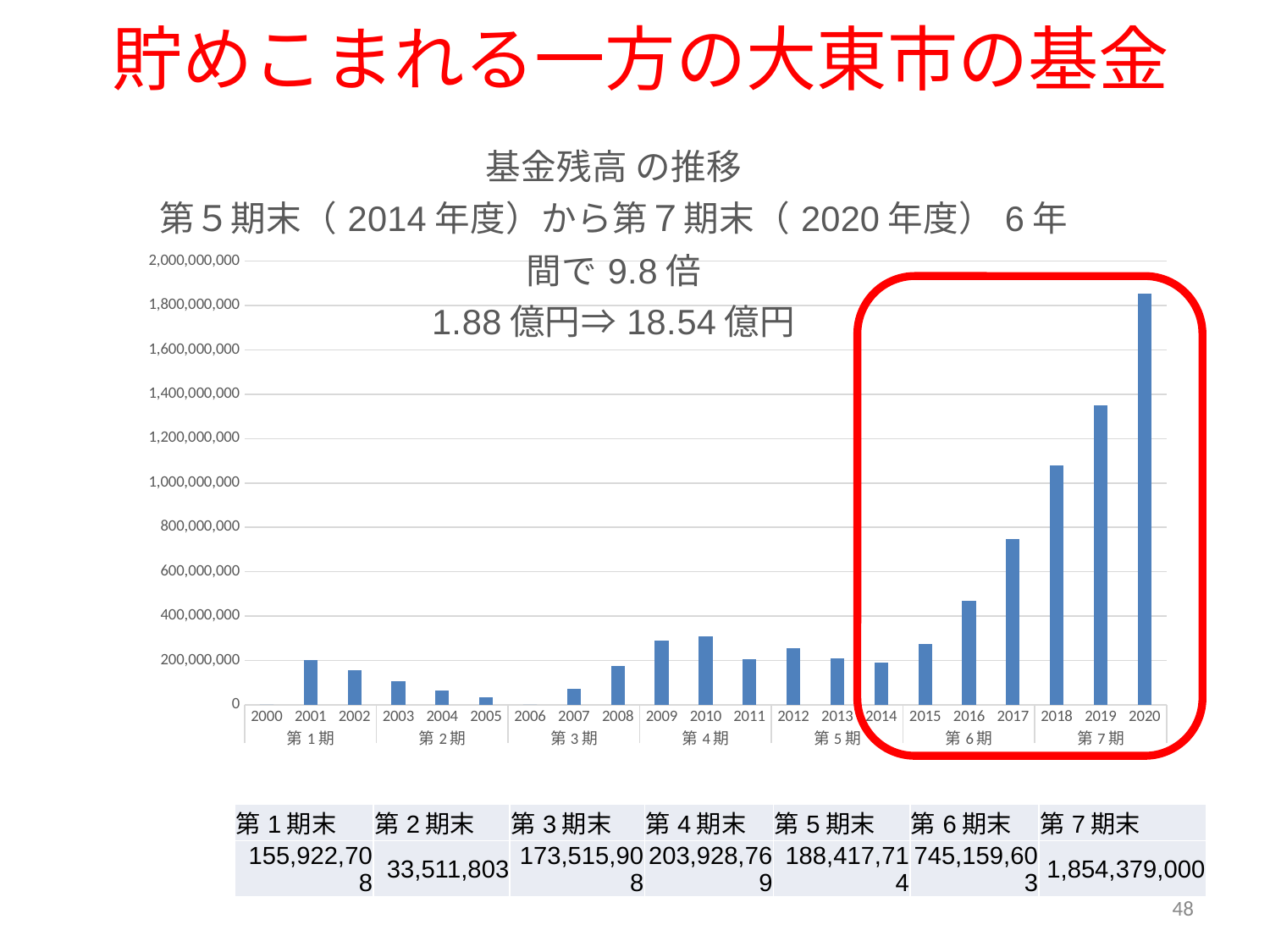
How many periods (期) are the years grouped into on the x axis? 7 According to the table below the chart, what is the fund balance at the end of 第7期 (2020)? 1,854,379,000 Which period-end value in the table is the lowest? 第2期末 (33,511,803) Is the value for 2019 greater or less than 1,200,000,000? greater What is the difference between the 第7期末 and 第6期末 values in the table? 1,109,219,397 What is the title of the chart? 基金残高 の推移 第５期末（2014年度）から第７期末（2020年度）6年間で9.8倍 1.88億円⇒18.54億円 What type of chart is shown on the slide? bar chart Which year has the highest fund balance in the chart? 2020 According to the table below the chart, what is the fund balance at the end of 第5期 (2014)? 188,417,714 According to the table below the chart, what is the fund balance at the end of 第6期 (2017)? 745,159,603 How many years (categories) are shown along the x axis of the chart? 21 Do the fund balance values rise or fall from 2014 to 2020? rise